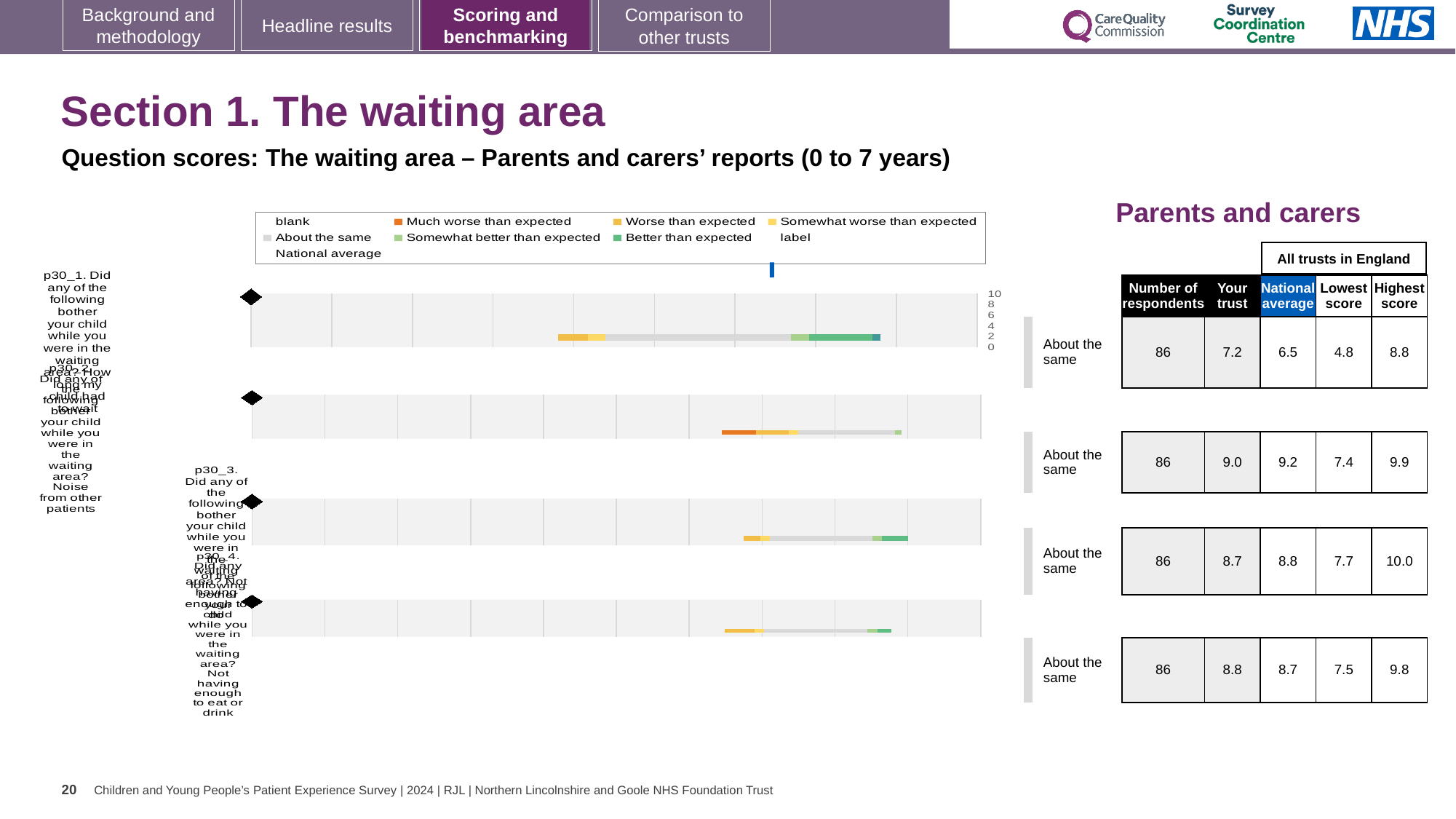
Which row has the lowest 'Your trust' score in the table? p30_1 (first row), 7.2 What is the highest value shown on the chart's score axis? 10 In the table, what is the 'Your trust' score for the first row (p30_1)? 7.2 What kind of chart is shown on the slide? bar chart In the table, what is the lowest score across all trusts in England for the fourth row (p30_4)? 7.5 In the chart legend, what colour represents 'Much worse than expected'? orange In the table, what is the national average for the second row (p30_2)? 9.2 Which row has the highest 'Your trust' score in the table? p30_2 (second row), 9.0 How many question rows (bars) are plotted in the chart? 4 What is the difference between the 'Your trust' score and the national average for the first row (p30_1)? 0.7 How many respondents are listed for each question in the table? 86 In the table, what is the highest score across all trusts in England for the third row (p30_3)? 10.0